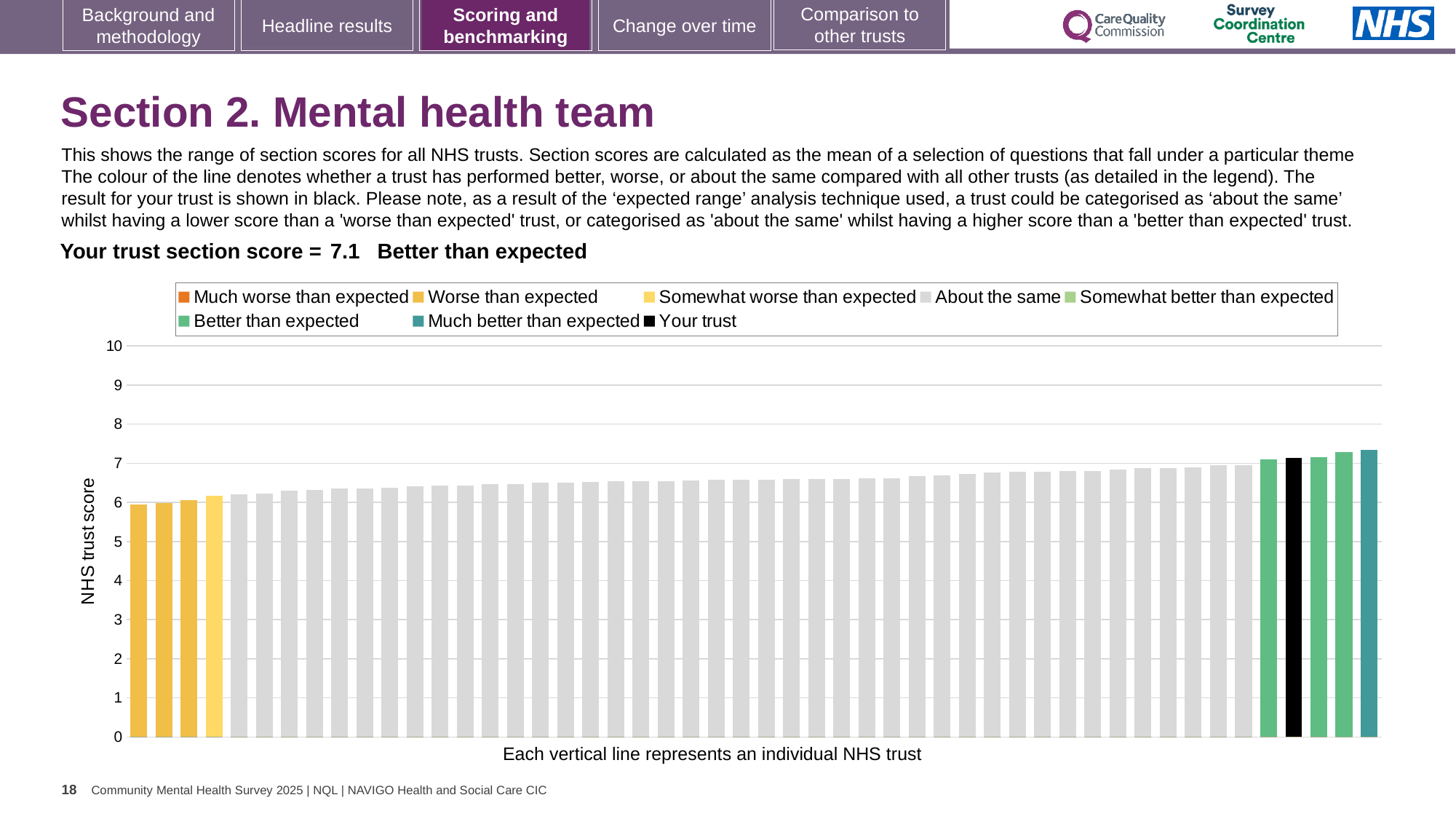
What is the section score for your trust shown on the slide? 7.1 Do the bar values rise or fall from left to right along the x axis? rise How many entries does the chart legend list? 8 Which legend category is your trust's section score placed in? Better than expected Is the value of the lowest bar greater or less than 7? less Which legend category does the highest bar on the chart belong to? Much better than expected How many bars are coloured as 'Worse than expected'? 3 What kind of chart is shown on the slide? bar chart What is the label on the y axis of the chart? NHS trust score Is the value of the lowest bar greater or less than 5? greater What colour is the bar representing your trust? black Is the value for your trust's bar greater or less than 7? greater